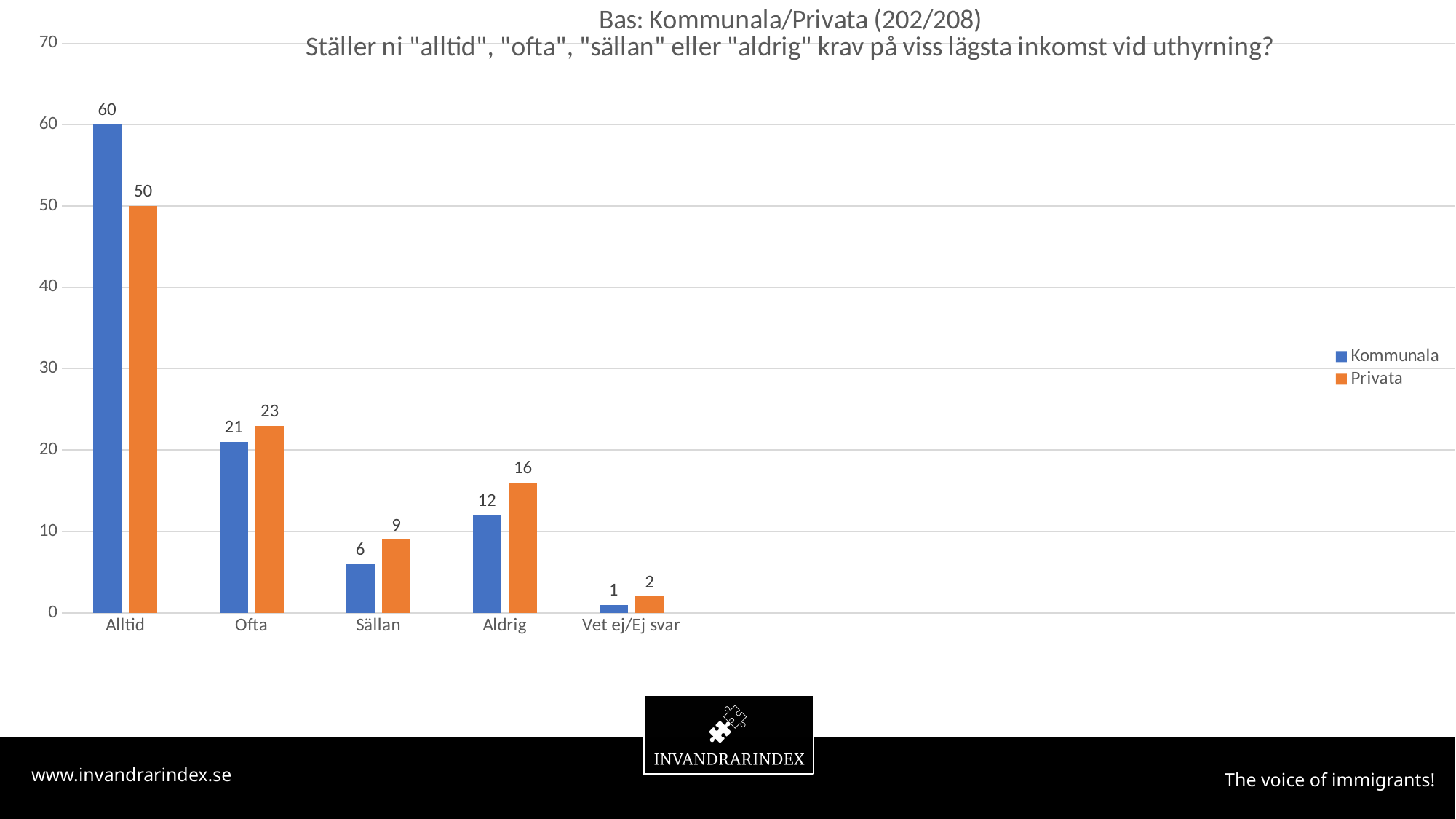
How many categories are shown on the x axis? 5 Is the value for Kommunala in the Ofta category greater or less than 30? less Which is larger in the Sällan category, Kommunala or Privata? Privata What is the value for Privata in the Aldrig category? 16 Which category has the highest value for Privata? Alltid What is the difference between the Kommunala and Privata values in the Alltid category? 10 What kind of chart is shown on the slide? bar chart How many series does the legend list? 2 What colour are the Privata bars? orange What is the value for Privata in the Ofta category? 23 What is the value for Kommunala in the Alltid category? 60 Which category has the lowest value for Kommunala? Vet ej/Ej svar